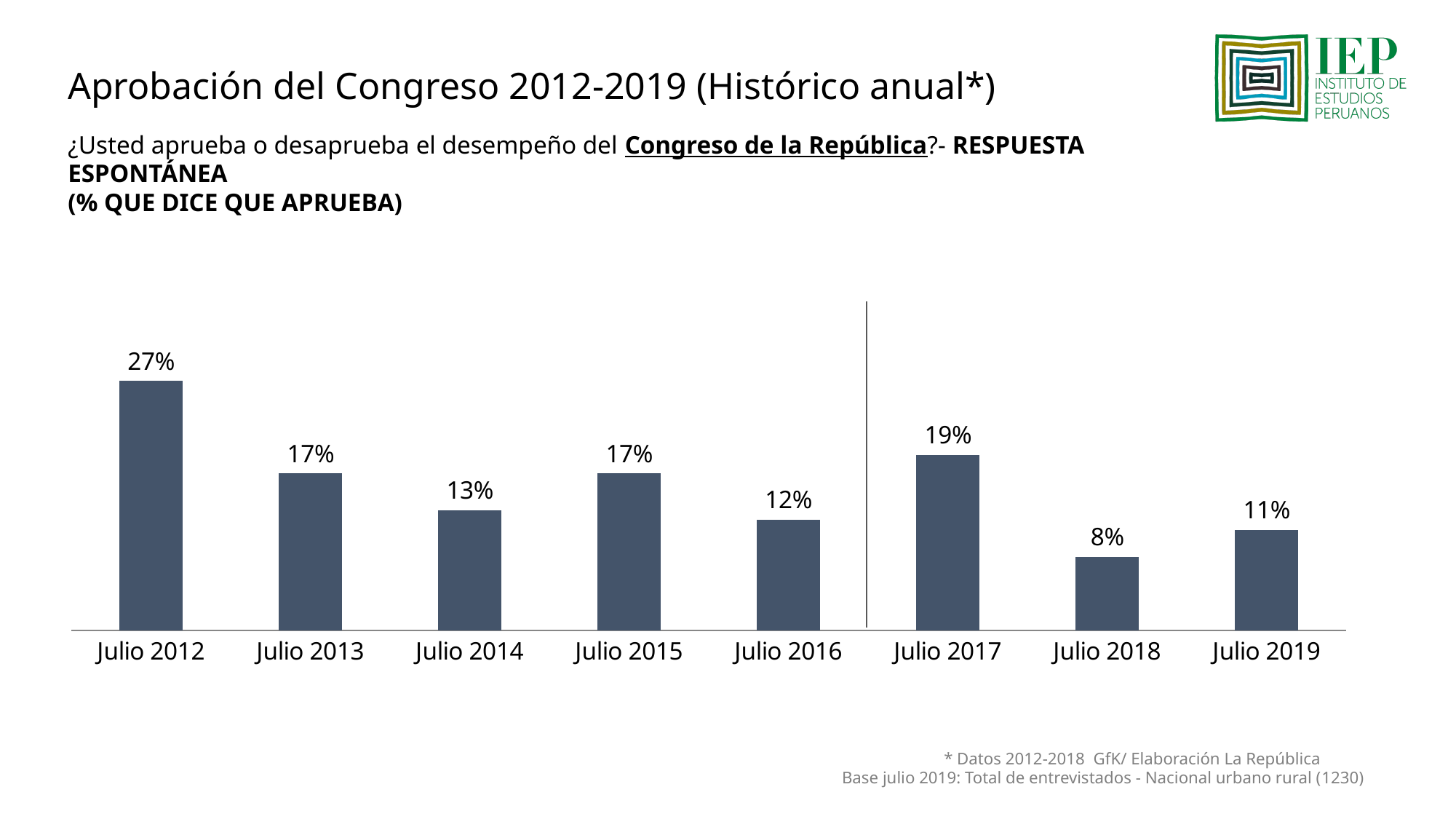
How many years (bars) are shown in the chart? 8 What is the approval value for Julio 2012? 27% Which year has the highest approval value? Julio 2012 What is the difference between the values for Julio 2017 and Julio 2018? 11% Do the values rise or fall from Julio 2017 to Julio 2018? Fall What is the approval value for Julio 2019? 11% What is the approval value for Julio 2018? 8% Which is larger, the value for Julio 2014 or the value for Julio 2016? Julio 2014 What is the approval value for Julio 2017? 19% What is the difference between the values for Julio 2012 and Julio 2013? 10% Which year has the lowest approval value? Julio 2018 What kind of chart is shown on the slide? Bar chart